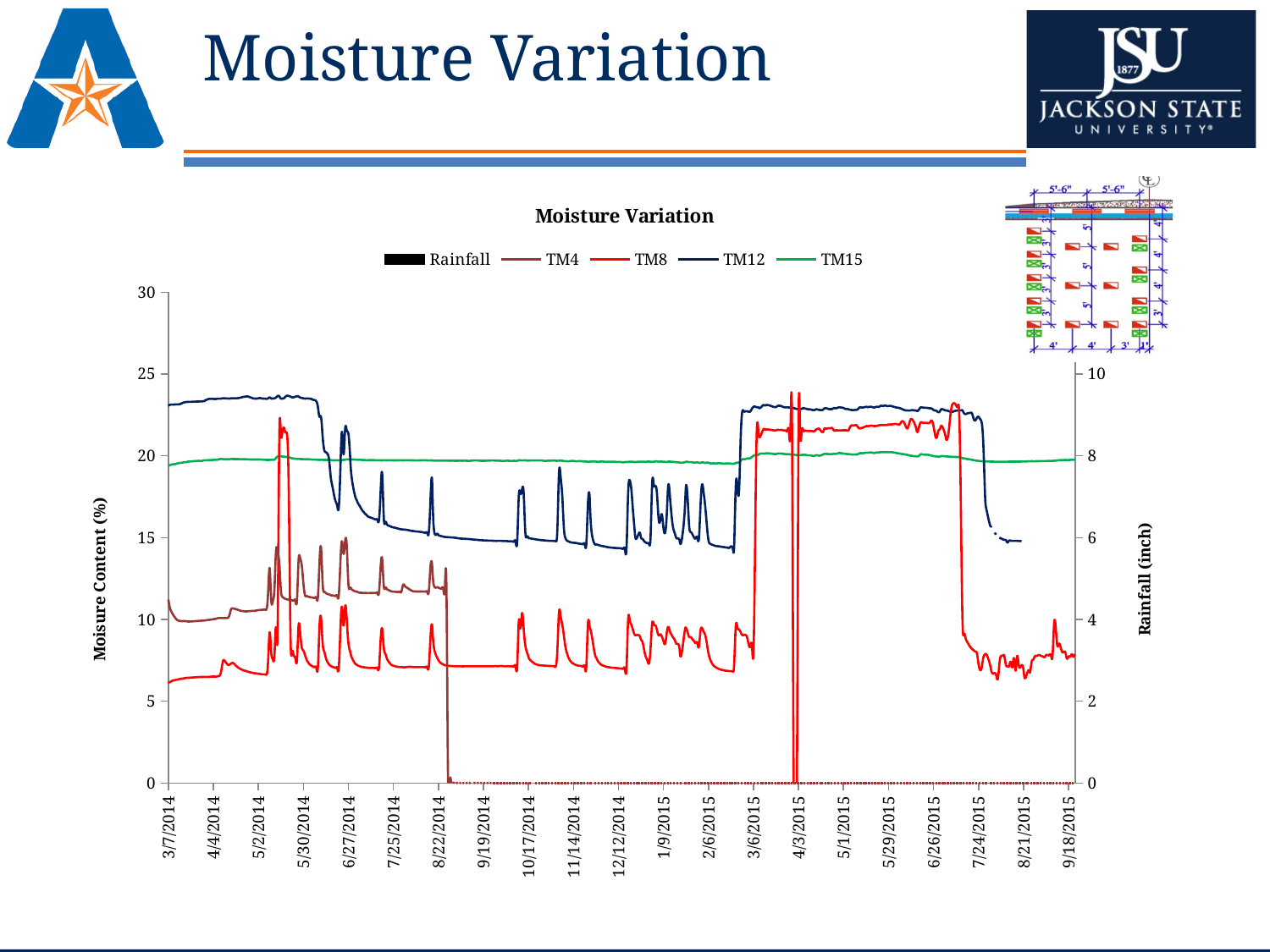
Is the TM8 moisture content at 3/7/2014 greater or less than 10? less At 3/7/2014, which series has the higher moisture content, TM4 or TM8? TM4 How many series does the legend of the Moisture Variation chart list? 5 What is the title of the chart? Moisture Variation What is the label of the right-hand vertical axis? Rainfall (inch) Is the TM12 moisture content at 3/7/2014 greater or less than 20? greater Is the TM8 moisture content at 5/1/2015 greater or less than 15? greater What type of chart is shown on the slide? line chart Does the TM12 moisture content rise or fall between 3/7/2014 and 8/22/2014? fall At 3/7/2014, which series has the higher moisture content, TM12 or TM15? TM12 Which moisture series has the highest value at 3/7/2014? TM12